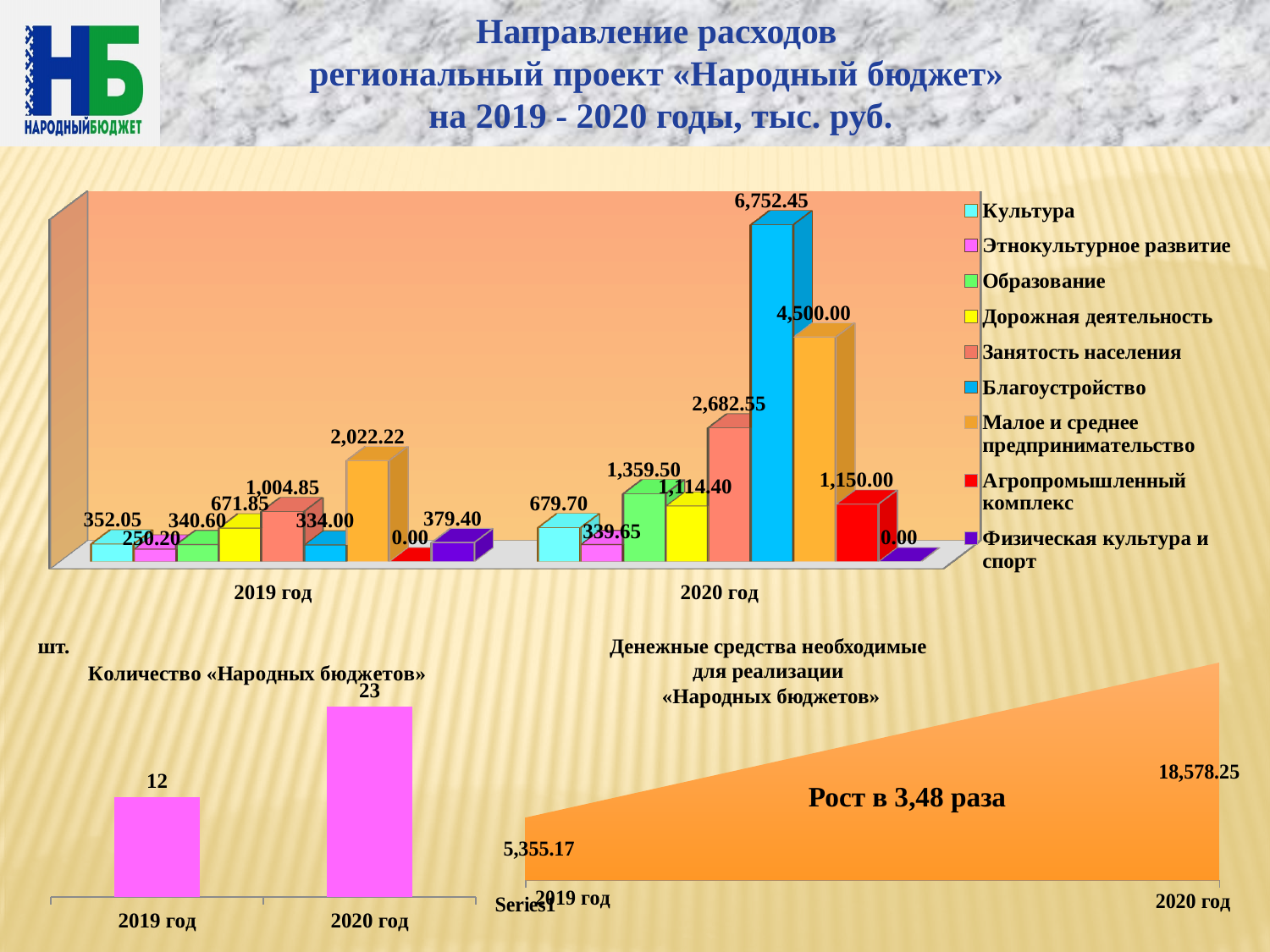
In the bottom-right chart «Денежные средства необходимые для реализации «Народных бюджетов»», what is the value for 2019 год? 5,355.17 In the top chart, what is the value for Малое и среднее предпринимательство in 2019 год? 2,022.22 In the chart titled «Количество «Народных бюджетов»», what is the value for 2020 год? 23 What kind of chart is the top chart? Bar chart In the top chart, which category has the highest value in 2020 год? Благоустройство In the top chart, what is the difference between the Занятость населения values for 2020 год and 2019 год? 1,677.70 In the top chart, what is the value for Благоустройство in 2020 год? 6,752.45 In the top chart, which category has the lowest value in 2019 год? Агропромышленный комплекс In the top chart, which is larger: Образование in 2020 год or Дорожная деятельность in 2020 год? Образование in 2020 год In the chart titled «Количество «Народных бюджетов»», what is the difference between 2020 год and 2019 год? 11 In the bottom-right chart «Денежные средства необходимые для реализации «Народных бюджетов»», do the values rise or fall from 2019 год to 2020 год? Rise How many series does the legend of the top chart list? 9